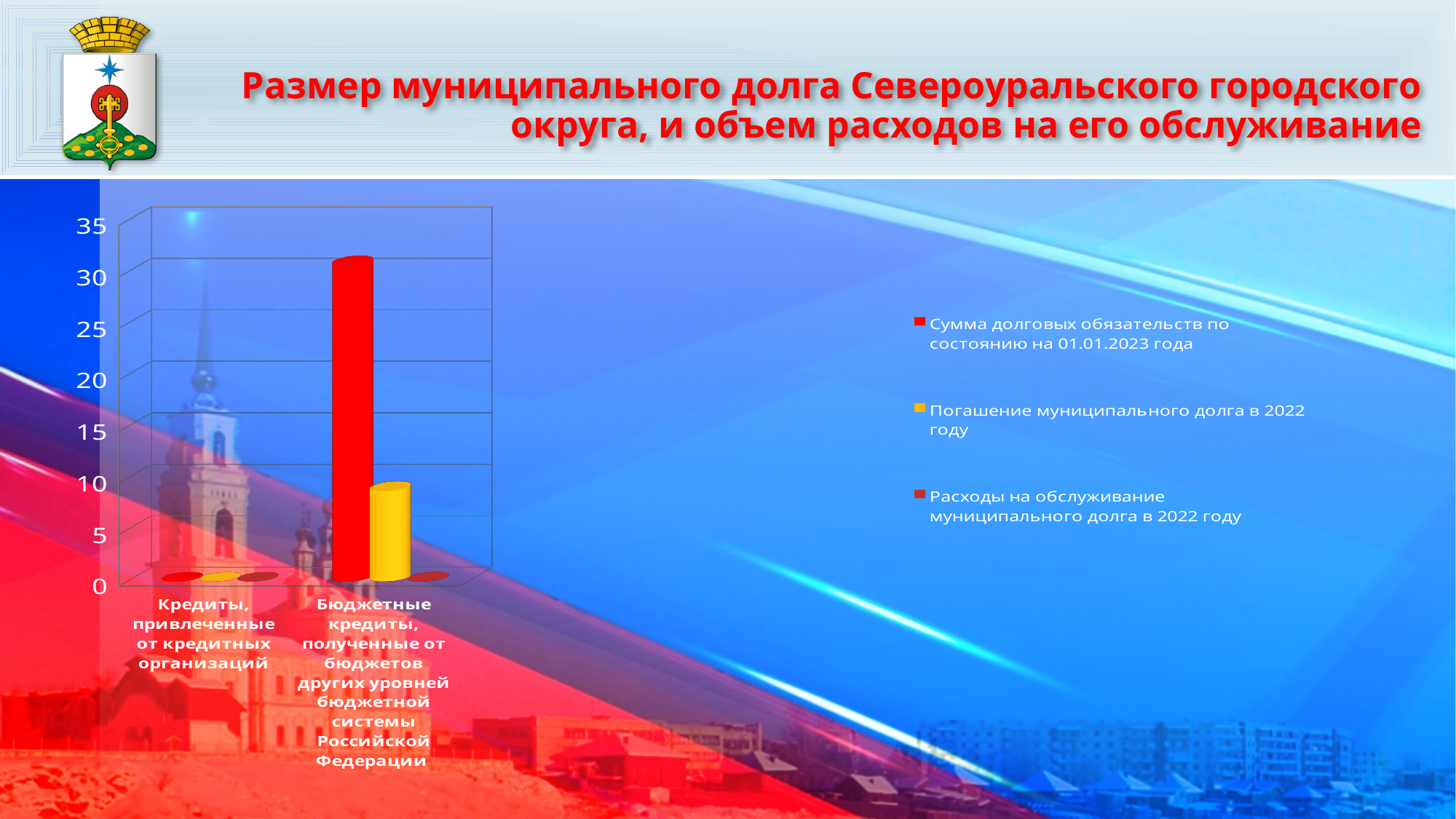
Is the value for "Погашение муниципального долга в 2022 году" in the category "Бюджетные кредиты, полученные от бюджетов других уровней бюджетной системы Российской Федерации" greater or less than 5? greater How many categories are shown on the x axis of the chart? 2 Is the value for "Сумма долговых обязательств по состоянию на 01.01.2023 года" in the category "Кредиты, привлеченные от кредитных организаций" greater or less than 5? less Is the value for "Сумма долговых обязательств по состоянию на 01.01.2023 года" in the category "Бюджетные кредиты, полученные от бюджетов других уровней бюджетной системы Российской Федерации" greater or less than 35? less How many series does the chart legend list? 3 What colour represents the series "Погашение муниципального долга в 2022 году" in the chart? yellow In the category "Бюджетные кредиты, полученные от бюджетов других уровней бюджетной системы Российской Федерации", which is larger: "Сумма долговых обязательств по состоянию на 01.01.2023 года" or "Погашение муниципального долга в 2022 году"? Сумма долговых обязательств по состоянию на 01.01.2023 года What is the highest value shown on the chart's vertical axis? 35 Which category has the higher value for "Сумма долговых обязательств по состоянию на 01.01.2023 года"? Бюджетные кредиты, полученные от бюджетов других уровней бюджетной системы Российской Федерации What kind of chart is shown on the slide? bar chart